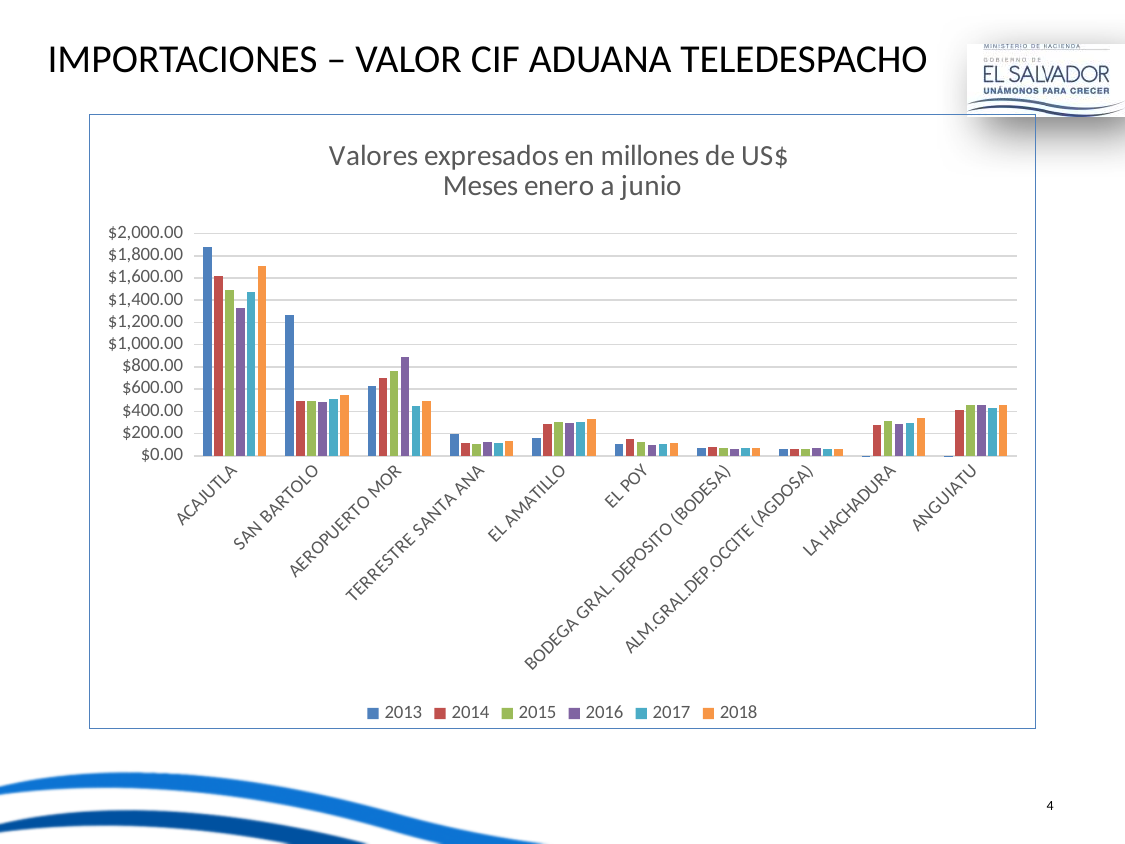
What kind of chart is shown on the slide? bar chart For SAN BARTOLO, did the value rise or fall from 2013 to 2014? fall For ACAJUTLA, which is larger: the 2013 value or the 2018 value? 2013 What is the first line of the chart title? Valores expresados en millones de US$ For LA HACHADURA, which series has the lowest bar? 2013 Is the 2013 value for SAN BARTOLO greater or less than $1,000.00? greater How many series does the legend list? 6 How many customs offices (categories) are shown on the x axis? 10 Is the 2013 value for ACAJUTLA greater or less than $1,600.00? greater Is the 2014 value for EL POY greater or less than $200.00? less Which category has the tallest bar in the chart? ACAJUTLA